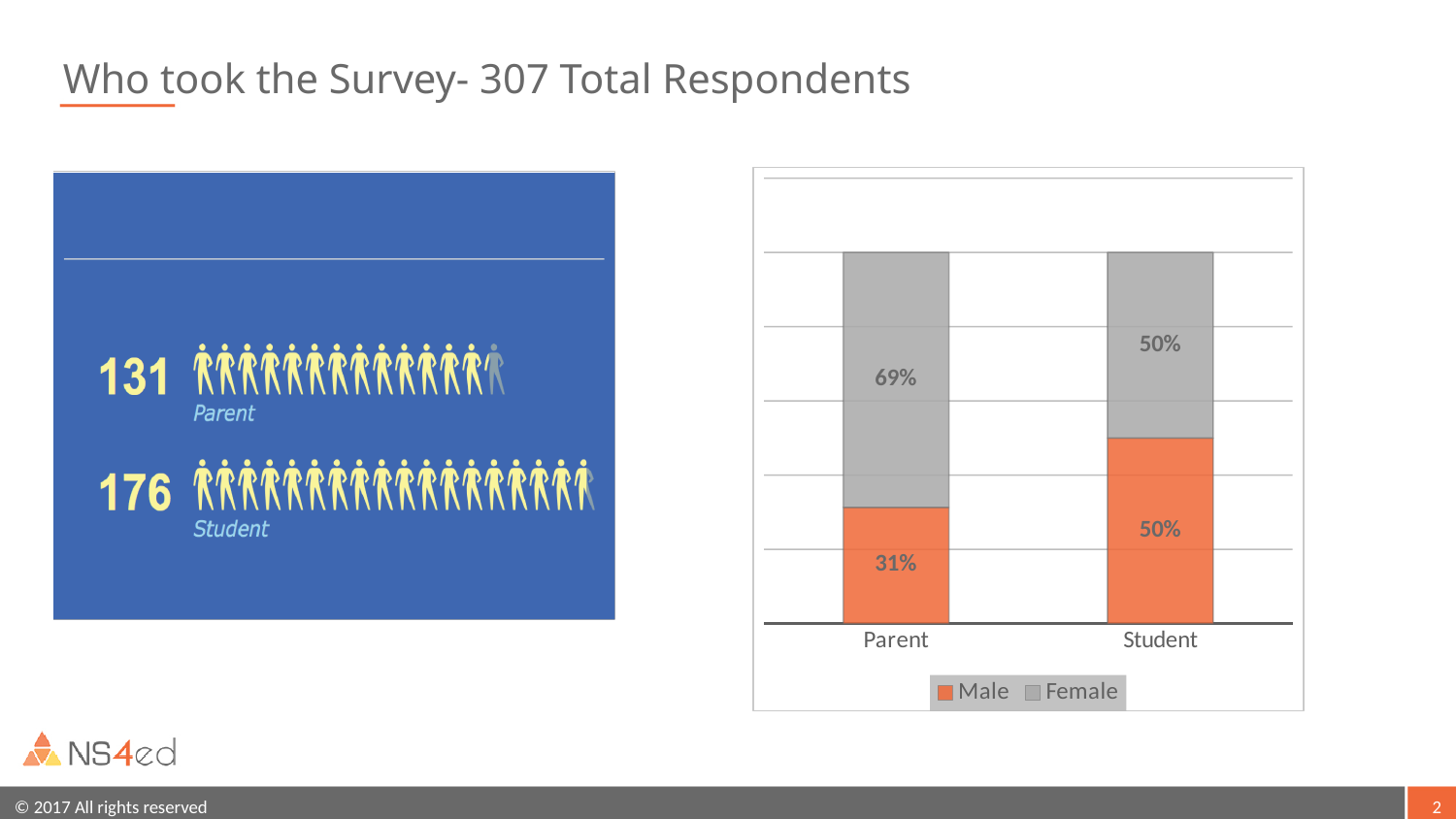
In the stacked bar chart, which category has the higher Female percentage? Parent What are the two legend entries in the stacked bar chart? Male and Female In the stacked bar chart, what is the total of the Parent bar? 100% In the stacked bar chart, what percentage of Student respondents are Female? 50% How many categories are shown on the x axis of the stacked bar chart? 2 In the stacked bar chart, what percentage of Parent respondents are Female? 69% In the stacked bar chart, what percentage of Student respondents are Male? 50% What kind of chart is shown on the right side of the slide? Stacked bar chart How many series does the legend of the stacked bar chart list? 2 In the stacked bar chart, what is the difference between the Female and Male percentages for Parent? 38% In the stacked bar chart, which category has the larger Male percentage, Parent or Student? Student In the stacked bar chart, what percentage of Parent respondents are Male? 31%